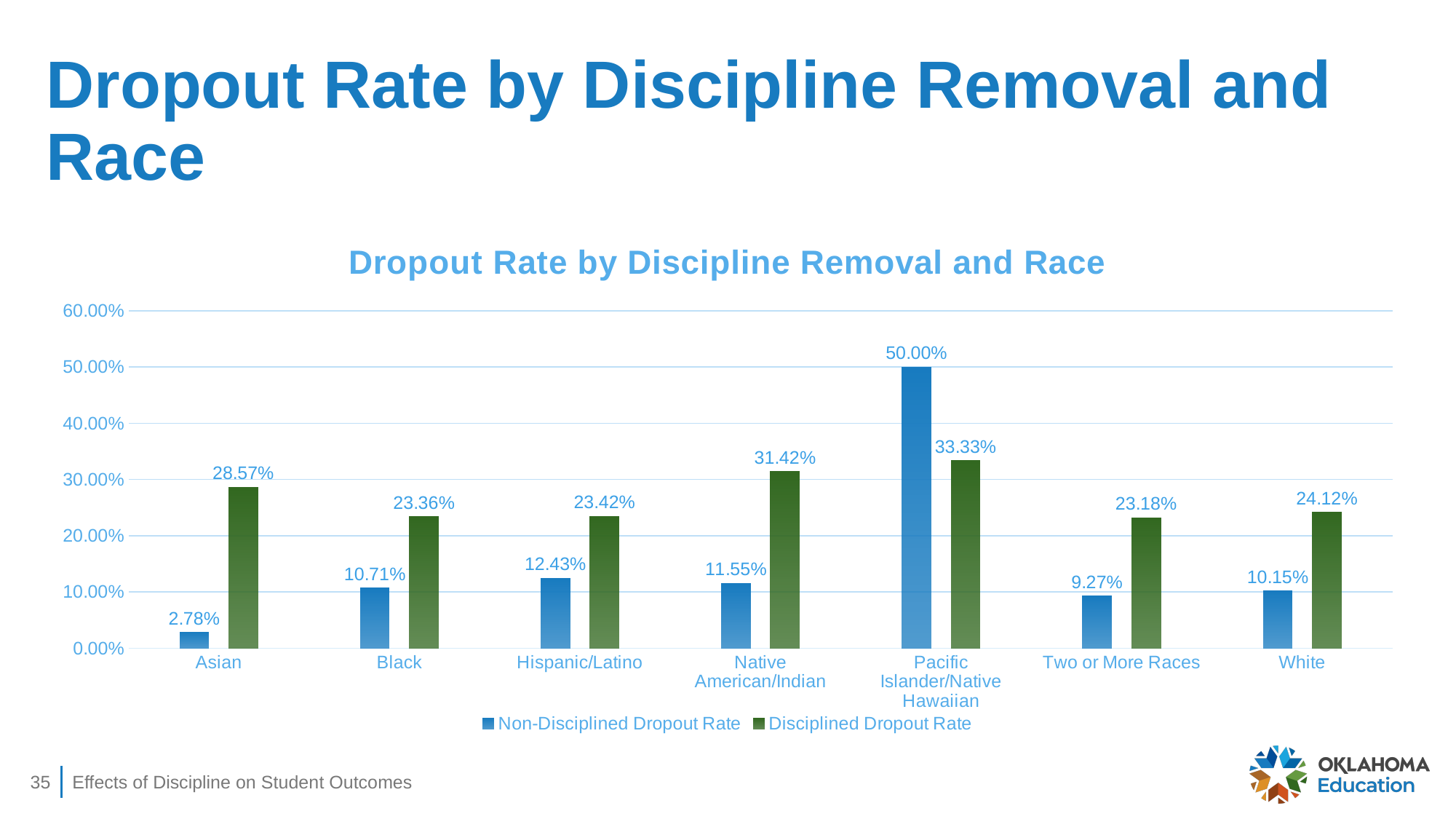
Which race category has the lowest Non-Disciplined Dropout Rate? Asian Which race category has the highest Non-Disciplined Dropout Rate? Pacific Islander/Native Hawaiian What is the Disciplined Dropout Rate for Native American/Indian students? 31.42% How many series does the legend list? 2 What is the Disciplined Dropout Rate for White students? 24.12% Which race category has the lowest Disciplined Dropout Rate? Two or More Races What kind of chart is shown on the slide? Bar chart What is the difference between the Disciplined and Non-Disciplined Dropout Rates for Black students? 12.65% Which is larger for Pacific Islander/Native Hawaiian students: the Non-Disciplined Dropout Rate or the Disciplined Dropout Rate? Non-Disciplined Dropout Rate What is the Non-Disciplined Dropout Rate for Asian students? 2.78% How many race categories are shown on the x axis? 7 Is the Disciplined Dropout Rate for Asian students greater or less than 20.00%? greater